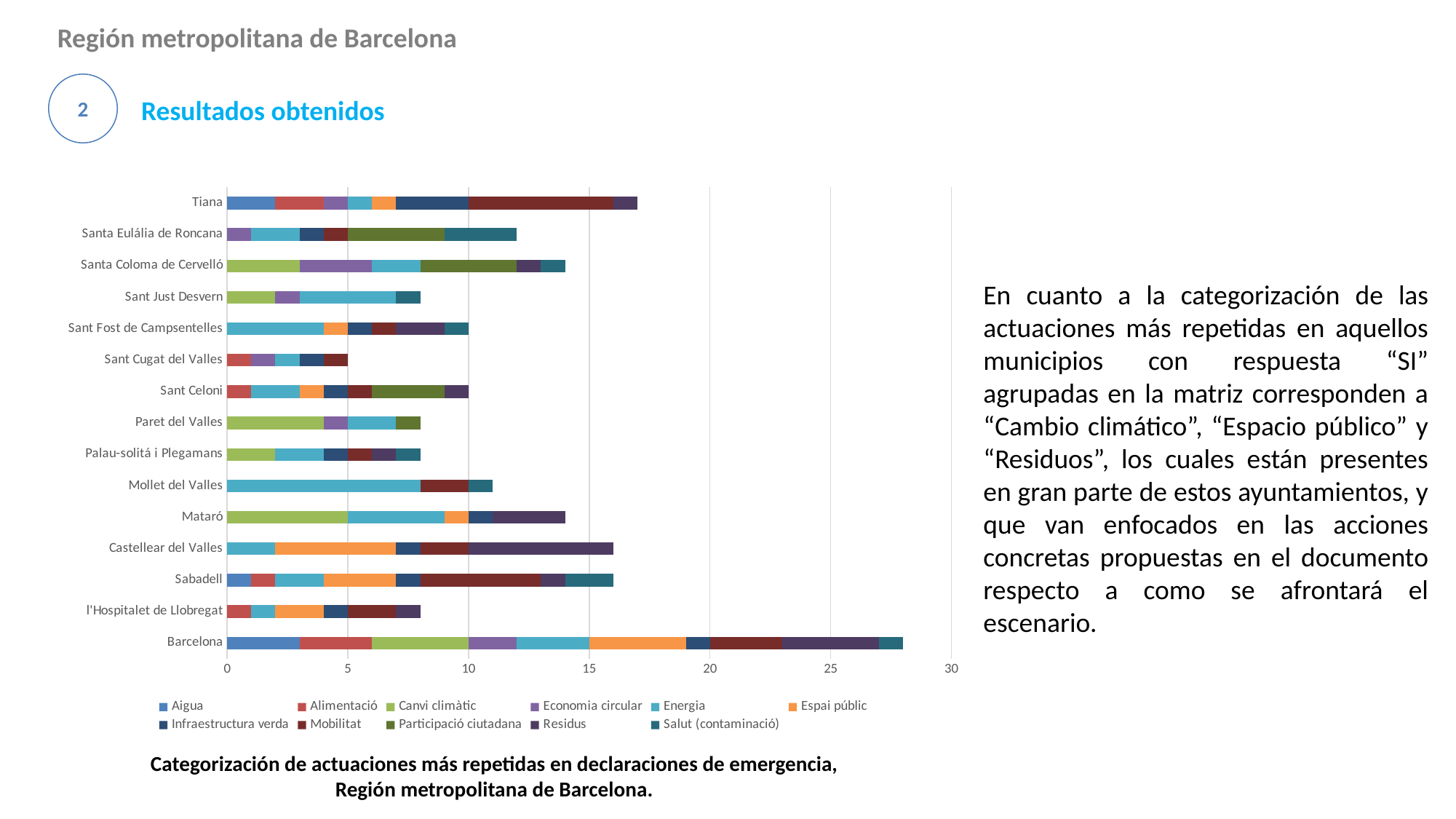
How many municipalities are listed on the vertical axis of the chart? 15 Which series is listed first in the chart legend? Aigua Which municipality has the longest bar in the chart? Barcelona Which has the longer bar, Mollet del Valles or Sant Just Desvern? Mollet del Valles Is the total value for Barcelona greater or less than 25? greater How many series does the chart legend list? 11 Which has the longer bar, Castellear del Valles or Mataró? Castellear del Valles Is the total value for Mataró greater or less than 15? less Is the total value for Sant Just Desvern greater or less than 10? less Which municipality has the shortest bar in the chart? Sant Cugat del Valles What kind of chart is shown on the slide? Stacked bar chart